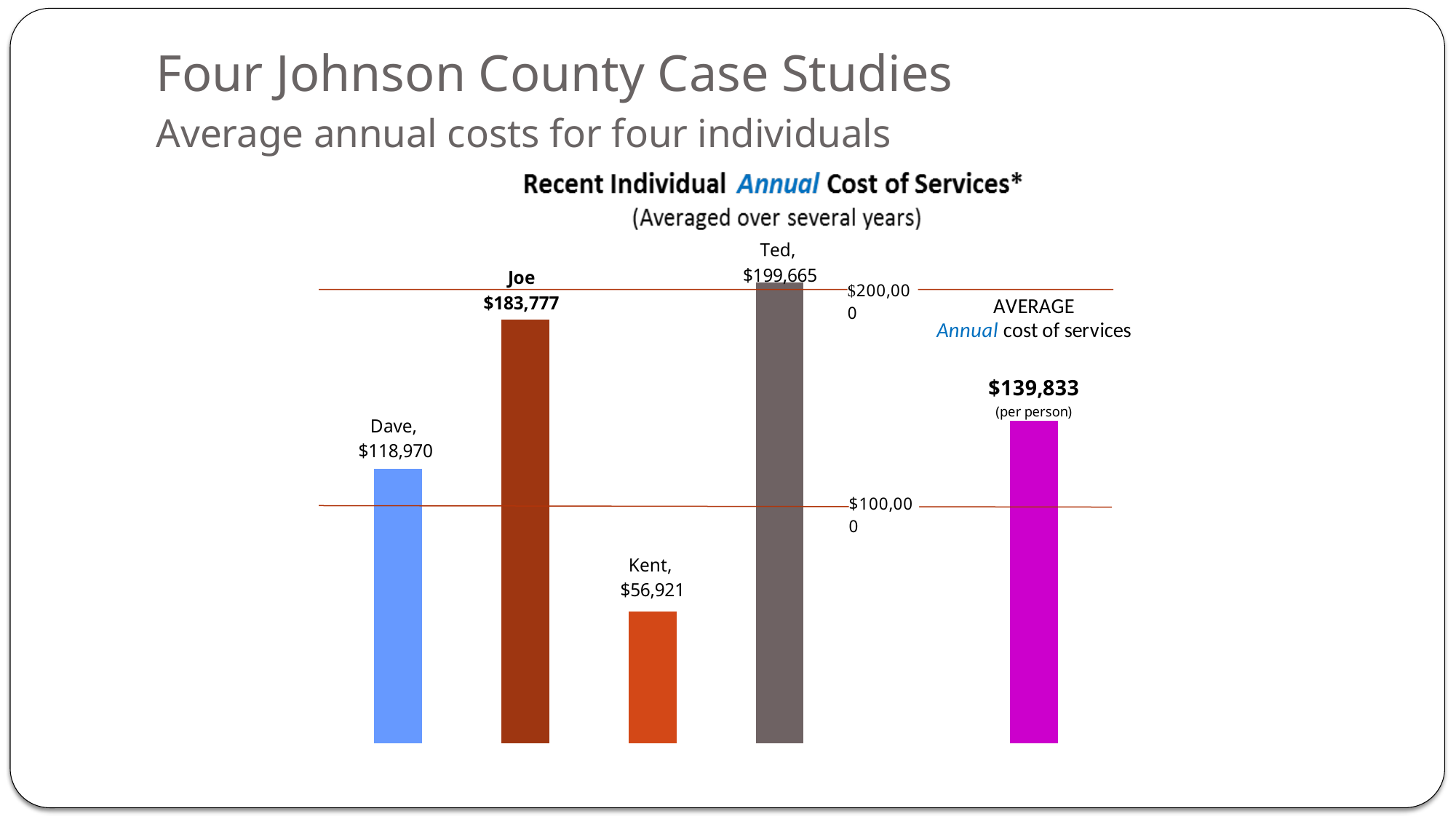
What is the annual cost of services for Kent? $56,921 How many individuals are plotted on the chart, excluding the average bar? 4 What is the average annual cost of services per person shown on the chart? $139,833 What is the difference between Dave's and Kent's annual cost of services? $62,049 What is the annual cost of services for Dave? $118,970 Which individual has the highest annual cost of services? Ted What kind of chart is shown on the slide? Bar chart What is the annual cost of services for Ted? $199,665 Which individual has the lowest annual cost of services? Kent Who has a higher annual cost of services, Joe or Dave? Joe Is the value for Kent greater or less than $100,000? less What is the difference between Ted's and Joe's annual cost of services? $15,888